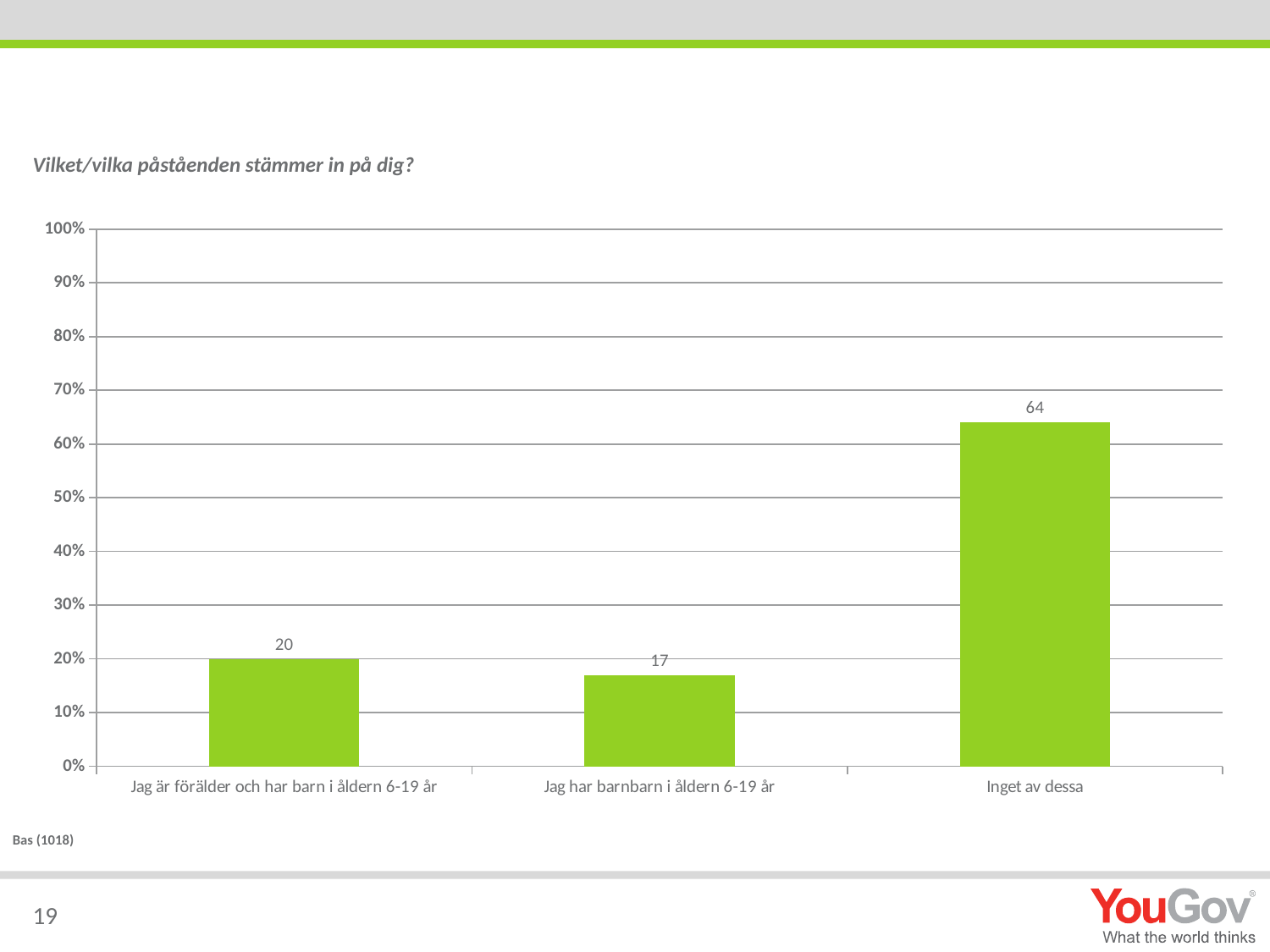
How many categories are shown in the chart? 3 Which category has the highest value? Inget av dessa Which category has the lowest value? Jag har barnbarn i åldern 6-19 år What kind of chart is shown on the slide? bar chart What is the value for "Inget av dessa"? 64 Is the value for "Inget av dessa" greater or less than 50%? greater What is the value for "Jag är förälder och har barn i åldern 6-19 år"? 20 What is the difference between the values for "Jag är förälder och har barn i åldern 6-19 år" and "Jag har barnbarn i åldern 6-19 år"? 3 What is the question shown above the chart? Vilket/vilka påståenden stämmer in på dig? Which is larger, the value for "Jag är förälder och har barn i åldern 6-19 år" or for "Jag har barnbarn i åldern 6-19 år"? Jag är förälder och har barn i åldern 6-19 år What is the difference between the values for "Inget av dessa" and "Jag är förälder och har barn i åldern 6-19 år"? 44 What is the value for "Jag har barnbarn i åldern 6-19 år"? 17